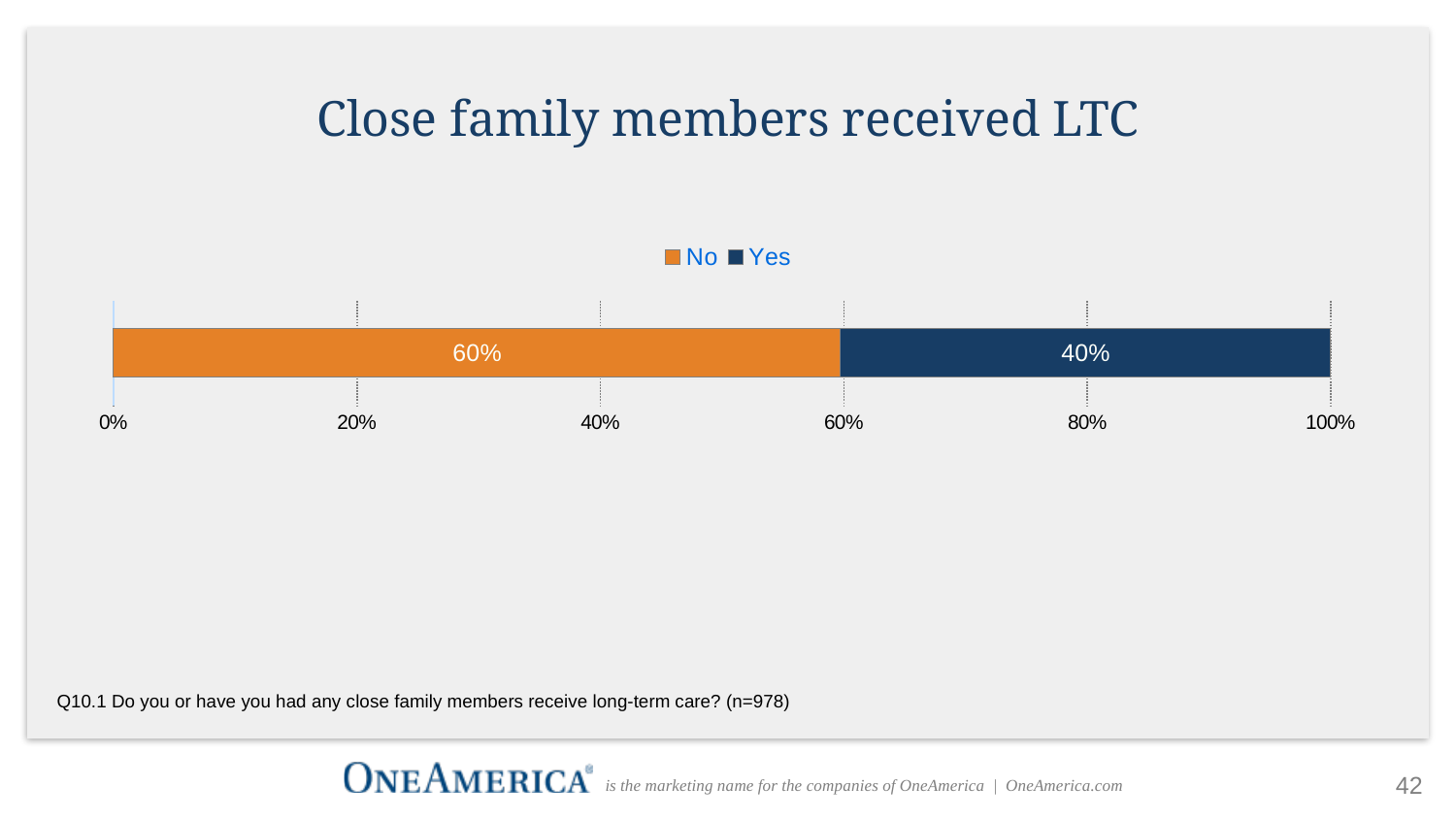
Which colour represents the "No" response in the chart? Orange What kind of chart is shown on the slide? Stacked bar chart How many series does the legend list? 2 What is the highest value shown on the x axis? 100% What is the difference in percentage points between the "No" and "Yes" responses? 20% Which response has the smallest share? Yes Is the value for "Yes" greater or less than 60%? less What percentage of respondents answered "No"? 60% What is the total of the two segments in the stacked bar? 100% Which response has the larger share, "No" or "Yes"? No What percentage of respondents answered "Yes"? 40% What is the title of the chart? Close family members received LTC